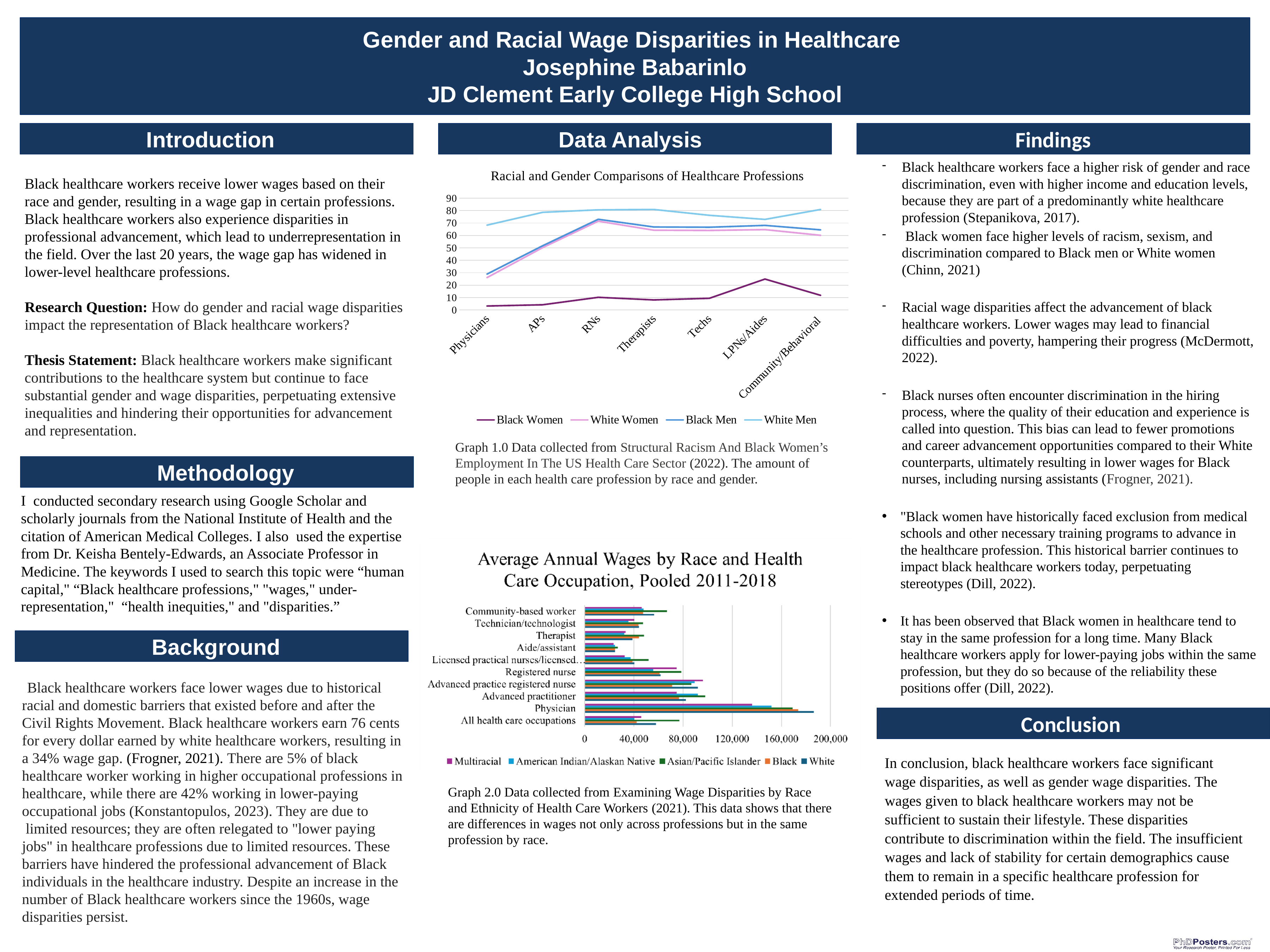
In the 'Racial and Gender Comparisons of Healthcare Professions' chart, does the Black Men series rise or fall from Physicians to RNs? rise In the 'Average Annual Wages by Race and Health Care Occupation, Pooled 2011-2018' chart, is the White value for Physician greater or less than 160,000? greater What kind of chart is the 'Average Annual Wages by Race and Health Care Occupation, Pooled 2011-2018' chart? bar chart How many series does the legend of the 'Racial and Gender Comparisons of Healthcare Professions' chart list? 4 In the 'Average Annual Wages by Race and Health Care Occupation, Pooled 2011-2018' chart, which occupation has the highest wages? Physician How many series does the legend of the 'Average Annual Wages by Race and Health Care Occupation, Pooled 2011-2018' chart list? 5 In the 'Racial and Gender Comparisons of Healthcare Professions' chart, which series has the lowest value for Physicians? Black Women How many professions are shown on the x axis of the 'Racial and Gender Comparisons of Healthcare Professions' chart? 7 In the 'Racial and Gender Comparisons of Healthcare Professions' chart, which series has the highest value for Physicians? White Men In the 'Racial and Gender Comparisons of Healthcare Professions' chart, is the value for Black Women at Physicians greater or less than 10? less In the 'Racial and Gender Comparisons of Healthcare Professions' chart, for which profession does the Black Women series reach its highest value? LPNs/Aides What kind of chart is the 'Racial and Gender Comparisons of Healthcare Professions' chart? line chart